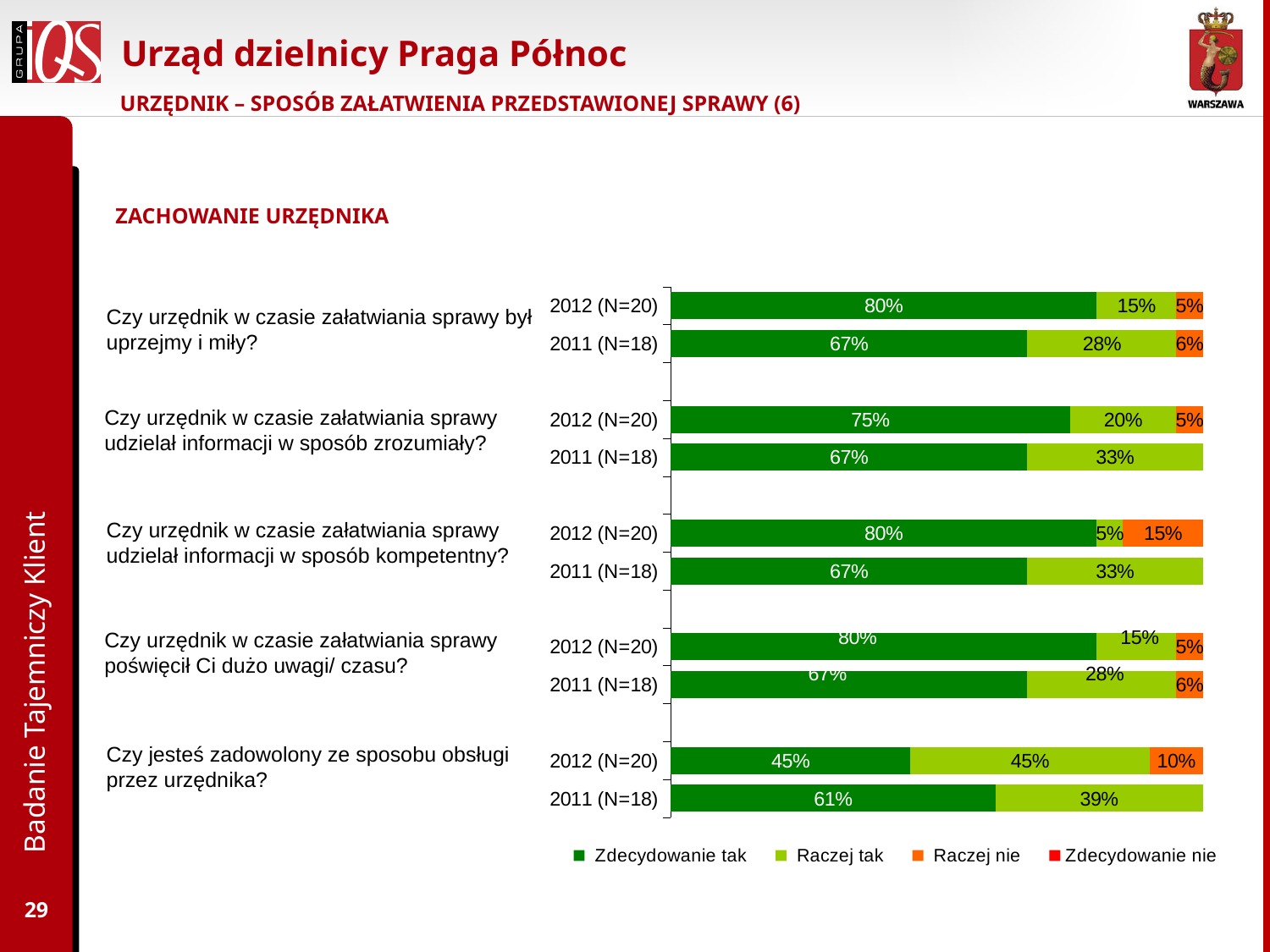
What is the 'Zdecydowanie tak' value for 2012 (N=20) for the question 'Czy urzędnik w czasie załatwiania sprawy udzielał informacji w sposób zrozumiały?' 75% What is the 'Raczej nie' value for 2012 (N=20) for the question 'Czy urzędnik w czasie załatwiania sprawy udzielał informacji w sposób kompetentny?' 15% What is the total of the 2012 (N=20) bar for the question 'Czy urzędnik w czasie załatwiania sprawy udzielał informacji w sposób zrozumiały?' 100% Which legend entry is shown in orange? Raczej nie How many bars are plotted in the chart? 10 For the question 'Czy jesteś zadowolony ze sposobu obsługi przez urzędnika?', what is the difference between the 'Zdecydowanie tak' values for 2011 (N=18) and 2012 (N=20)? 16% What is the 'Raczej tak' value for 2011 (N=18) for the question 'Czy jesteś zadowolony ze sposobu obsługi przez urzędnika?' 39% For the question 'Czy urzędnik w czasie załatwiania sprawy był uprzejmy i miły?', which year has the larger 'Zdecydowanie tak' value, 2012 (N=20) or 2011 (N=18)? 2012 (N=20) Which bar has the lowest 'Zdecydowanie tak' value in the chart? 2012 (N=20) for 'Czy jesteś zadowolony ze sposobu obsługi przez urzędnika?' What kind of chart is shown on the slide? stacked bar chart What is the 'Zdecydowanie tak' value for 2012 (N=20) for the question 'Czy jesteś zadowolony ze sposobu obsługi przez urzędnika?' 45% How many series does the legend list? 4